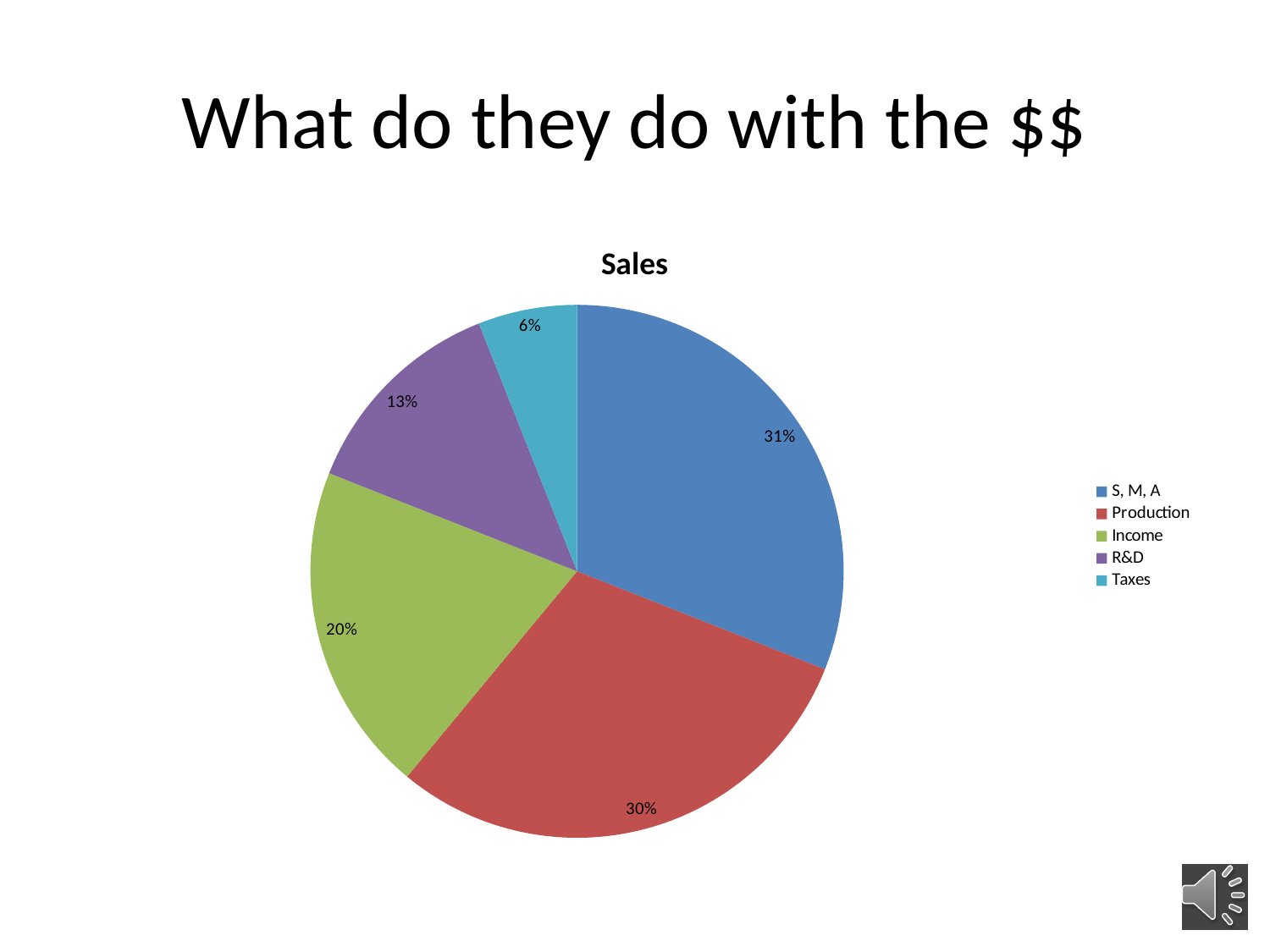
What share of the pie does R&D have? 13% How many categories does the legend list? 5 What colour is the Production slice? red Which is larger, the share for Income or the share for R&D? Income What share of the pie does Income have? 20% What kind of chart is shown on the slide? pie chart What is the chart's title? Sales What share of the pie does Taxes have? 6% What is the difference between the Income share and the Taxes share? 14% Which category has the smallest slice of the pie? Taxes